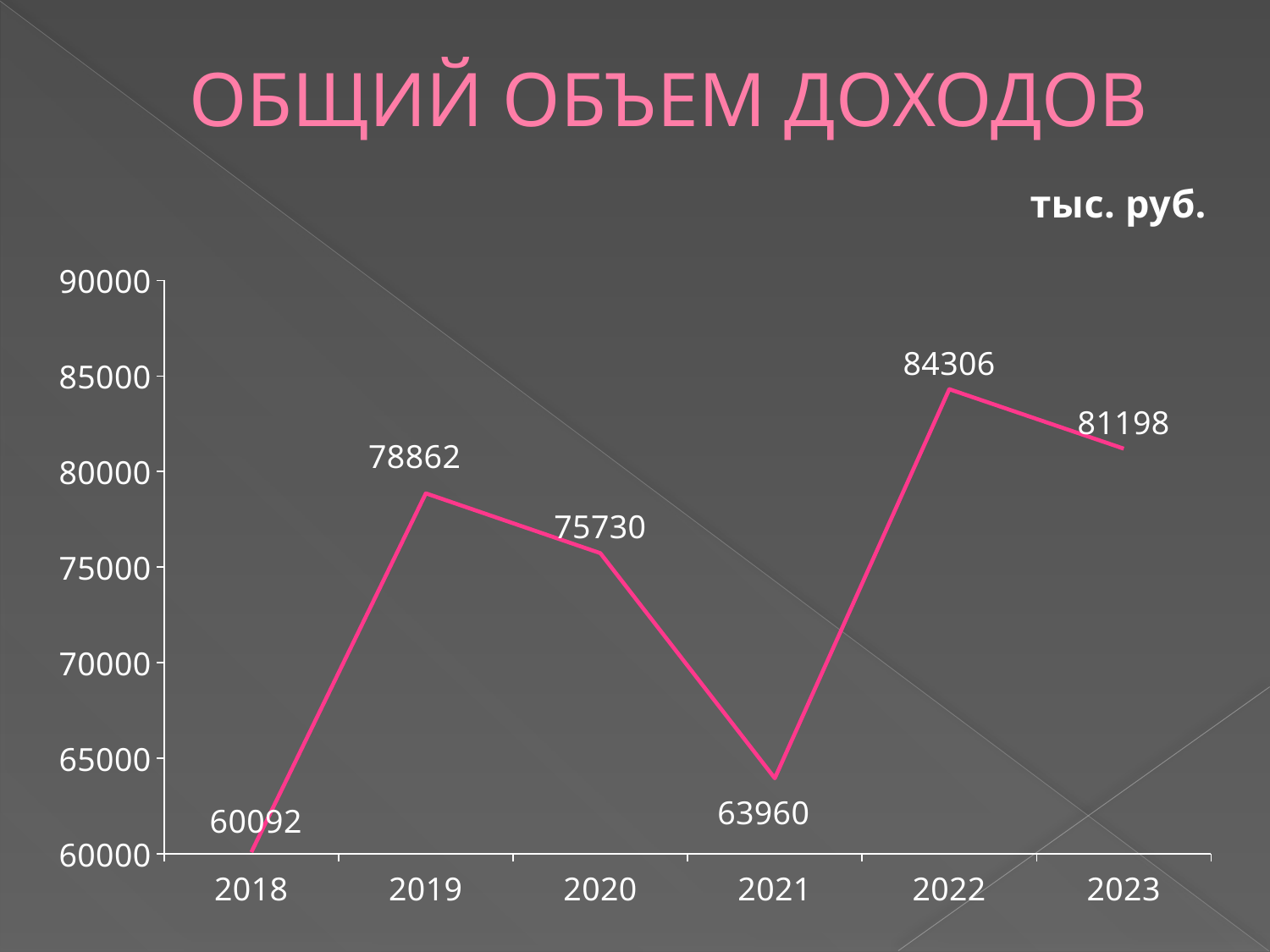
What is the difference between the values for 2022 and 2023? 3108 What is the title of the chart? ОБЩИЙ ОБЪЕМ ДОХОДОВ What kind of chart is shown on the slide? line chart What is the value for 2018? 60092 Which year has the lowest value? 2018 What is the value for 2023? 81198 What is the value for 2021? 63960 What is the difference between the values for 2019 and 2020? 3132 How many years are plotted on the chart? 6 Which is larger, the value for 2019 or the value for 2020? 2019 Is the value for 2021 greater or less than 65000? less Which year has the highest value? 2022